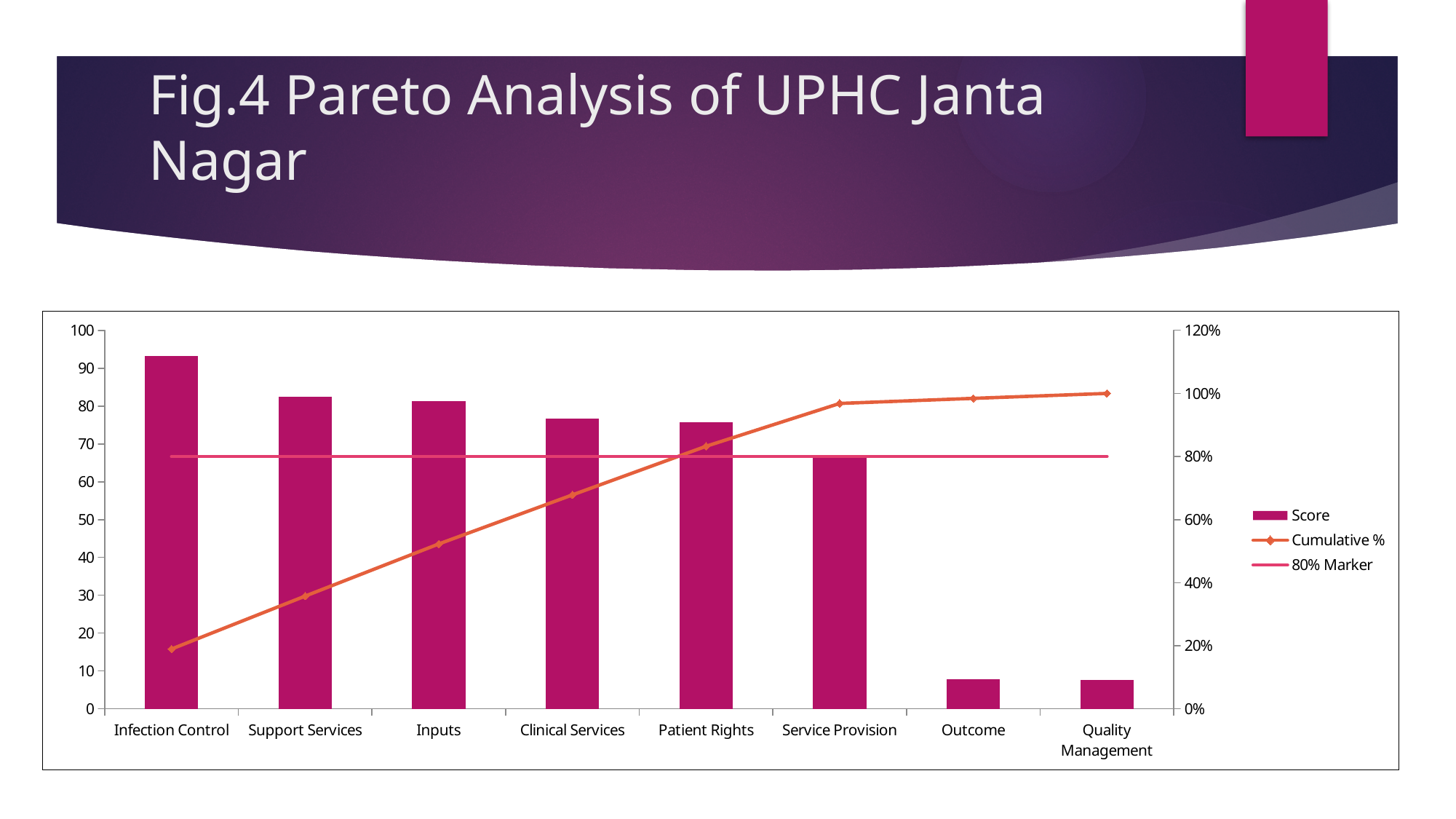
Is the Score for Outcome greater or less than 10? less How many series does the legend list? 3 Is the Score for Infection Control greater or less than 90? greater Which has a higher Score, Infection Control or Service Provision? Infection Control Which category has the highest Score bar? Infection Control Which has a higher Score, Clinical Services or Outcome? Clinical Services What is the title of the slide? Fig.4 Pareto Analysis of UPHC Janta Nagar Is the Score for Service Provision greater or less than 70? less Do the Score bars rise or fall from left to right along the x axis? fall How many categories are shown on the x axis? 8 Does the Cumulative % line rise or fall from left to right? rise